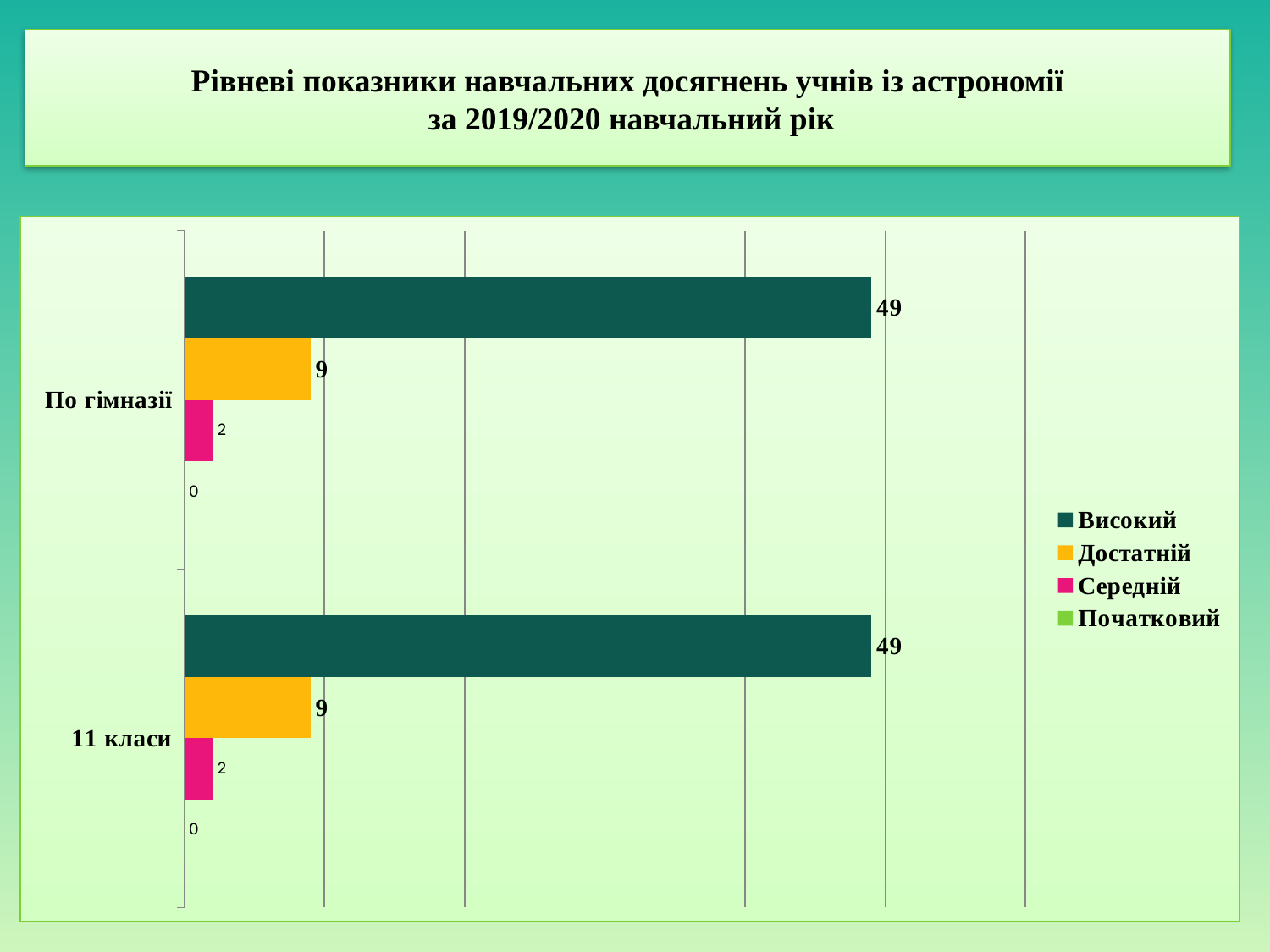
What is the value for Достатній in the category 11 класи? 9 Which is larger in the category 11 класи: Достатній or Середній? Достатній What kind of chart is shown on the slide? bar chart What is the value for Початковий in the category 11 класи? 0 How many categories are shown on the chart? 2 What is the value for Середній in the category По гімназії? 2 Which series has the lowest value in the category По гімназії? Початковий How many series does the legend list? 4 What is the difference between the Високий and Достатній values in the category По гімназії? 40 Which series has the highest value in the category 11 класи? Високий Which series is shown in dark green on the chart? Високий What is the value for Високий in the category По гімназії? 49